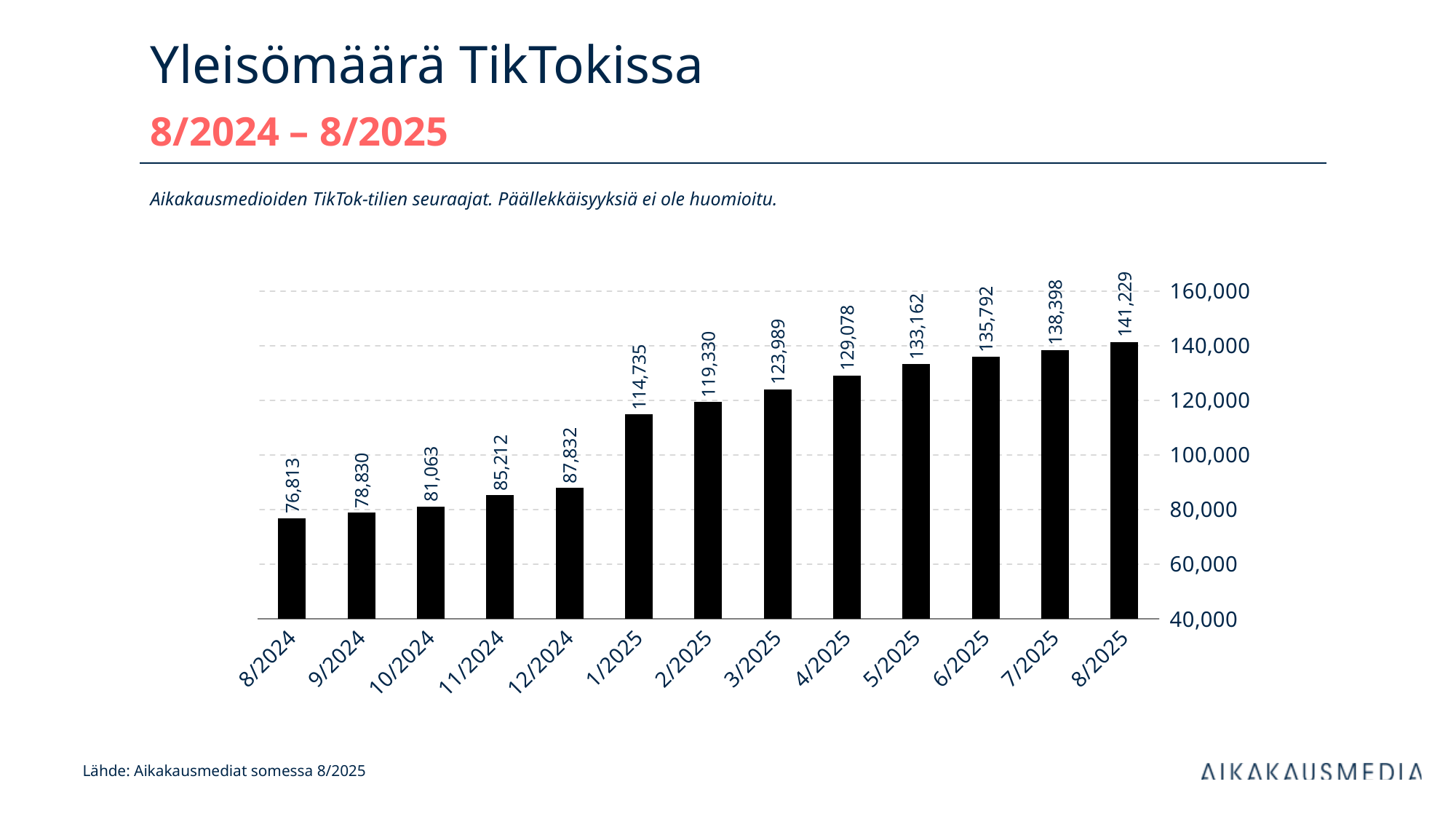
What is the difference between the values for 1/2025 and 12/2024? 26,903 What is the value for 1/2025? 114,735 Do the values rise or fall from 8/2024 to 8/2025? Rise What kind of chart is shown on the slide? Bar chart Which month has the highest value? 8/2025 Which is larger, the value for 3/2025 or the value for 11/2024? 3/2025 How many months are shown on the x axis? 13 Which month has the lowest value? 8/2024 What is the value for 8/2024? 76,813 What is the value for 8/2025? 141,229 What is the difference between the values for 8/2025 and 8/2024? 64,416 What is the value for 12/2024? 87,832